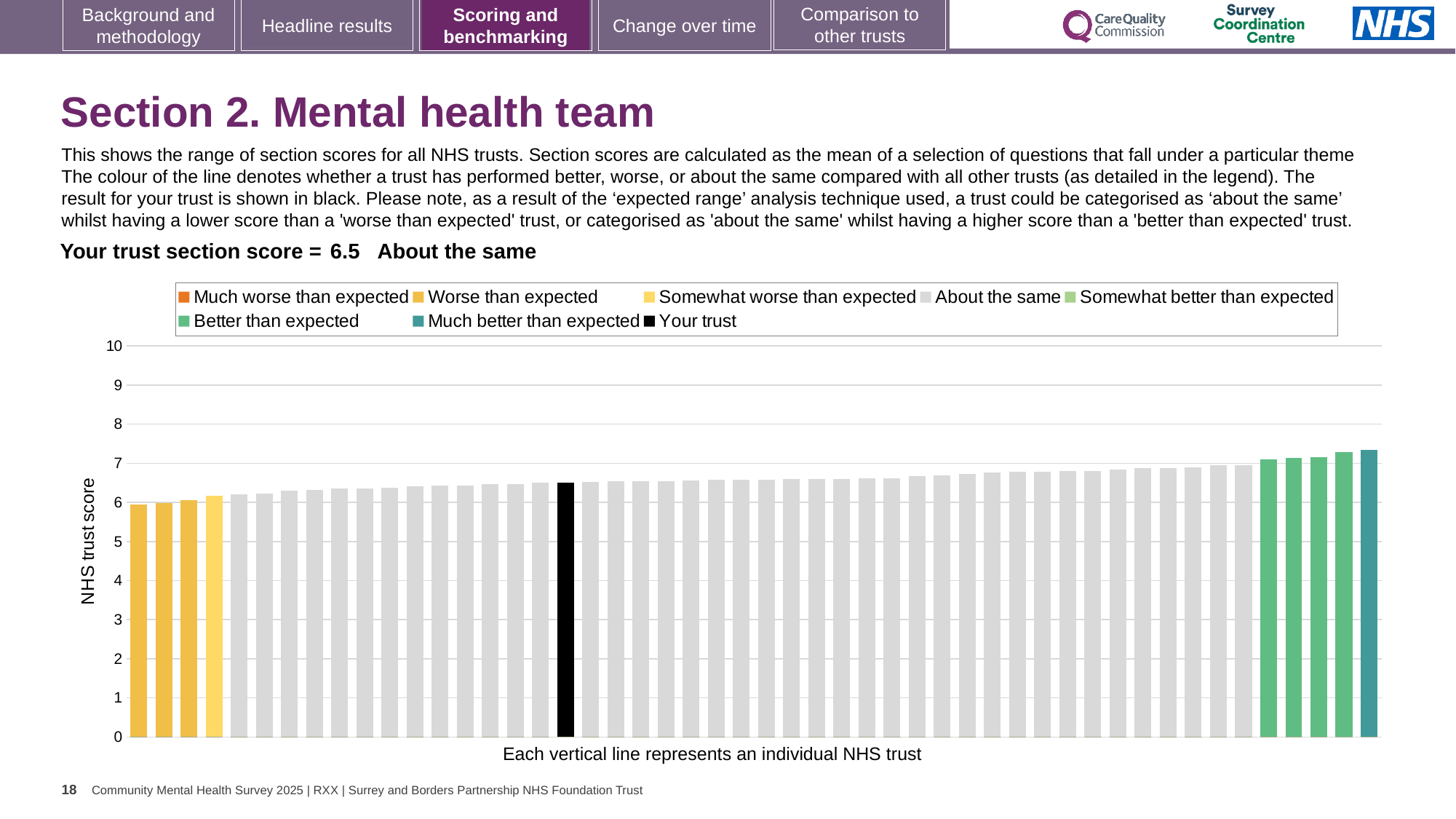
What is the section score for your trust shown on the slide? 6.5 Is the value for your trust (the black bar) greater or less than 7? less How many entries does the chart legend list? 8 Is the value of the tallest bar (rightmost) greater or less than 7? greater What is the label of the y axis? NHS trust score What is the highest value shown on the y axis? 10 What kind of chart is shown on the slide? bar chart Do the bar values rise or fall from left to right along the x axis? rise How many black bars are there in the chart? 1 Is the value of the shortest bar (leftmost) greater or less than 5? greater